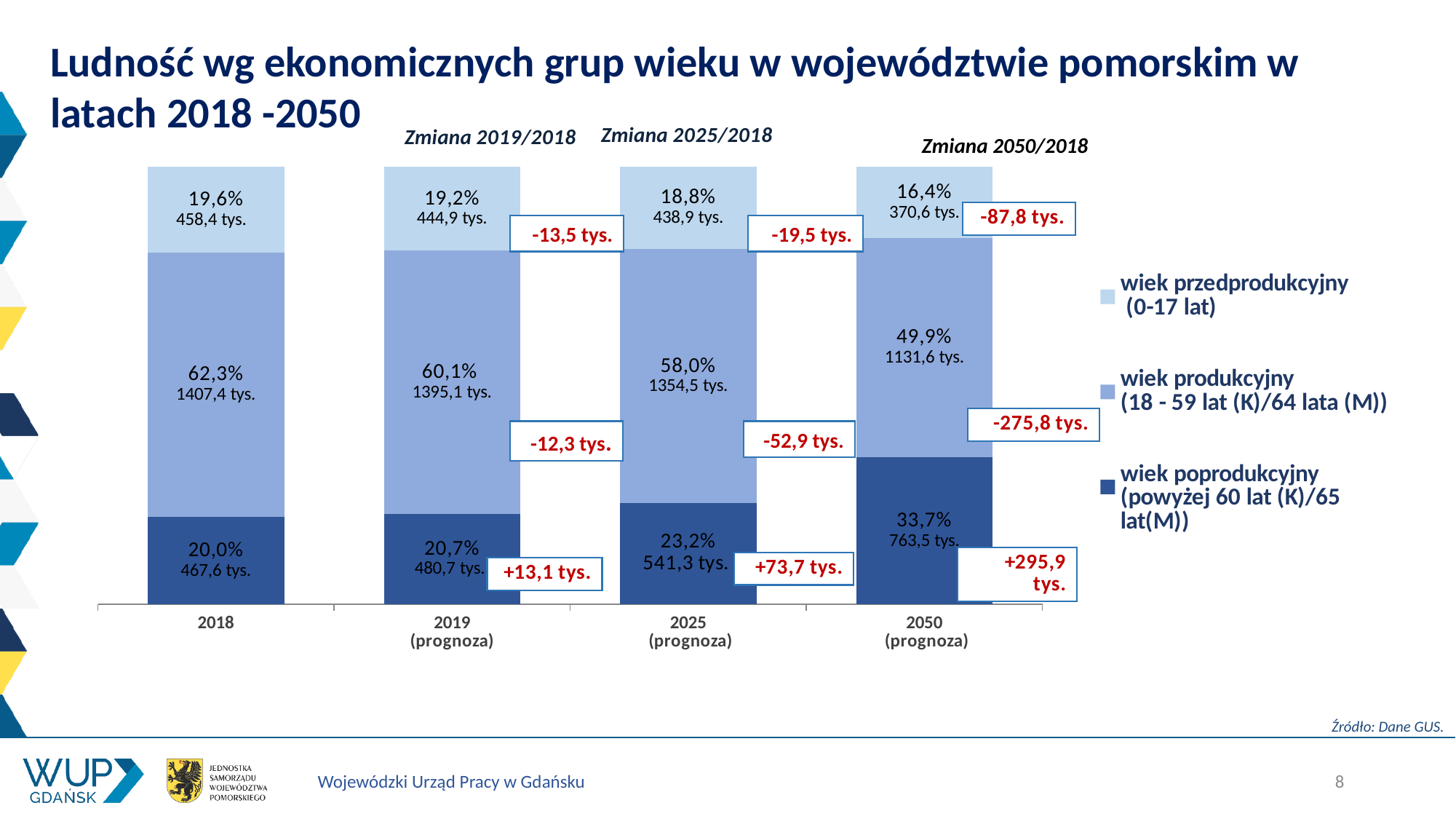
In which year is the share of the wiek przedprodukcyjny group the lowest? 2050 (prognoza) What kind of chart is shown on the slide? stacked bar chart What is the printed change (Zmiana 2050/2018) for the wiek poprodukcyjny group? +295,9 tys. How many people (in tys.) are forecast in the wiek poprodukcyjny group in 2050 (prognoza)? 763,5 tys. What is the difference in tys. between the wiek produkcyjny group in 2018 and in 2050 (prognoza)? 275,8 tys. In which year is the share of the wiek poprodukcyjny group the highest? 2050 (prognoza) How many years (categories) are shown on the x axis? 4 What is the total population in tys. for the 2018 bar (sum of the three groups)? 2333,4 tys. What share of the population was in the wiek produkcyjny group in 2018? 62,3% How many series does the legend list? 3 In 2025 (prognoza), which group has the larger share: wiek przedprodukcyjny or wiek poprodukcyjny? wiek poprodukcyjny Does the share of the wiek produkcyjny group rise or fall from 2018 to 2050? fall